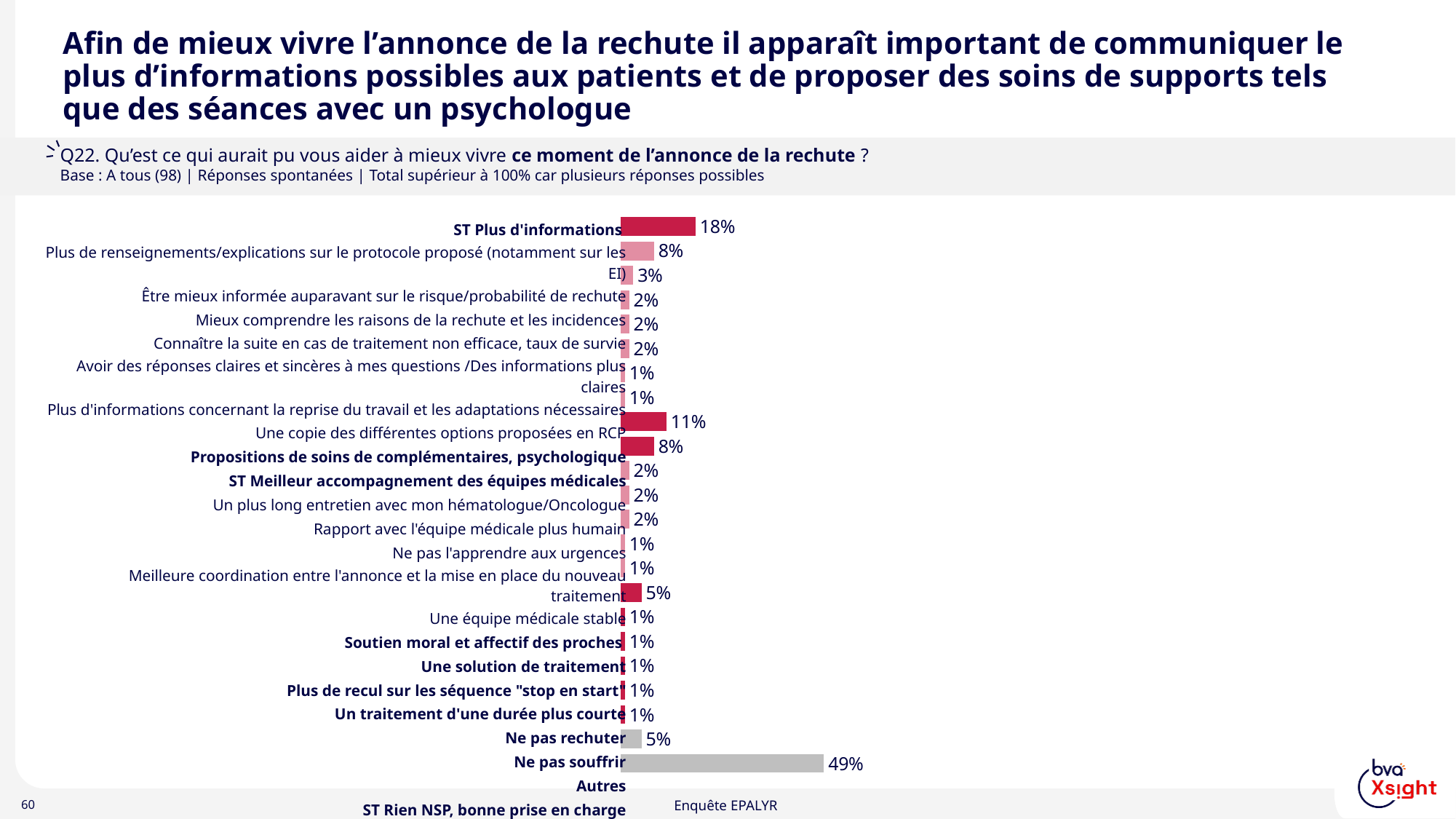
What is the second-highest value shown in the chart? 18% What is the value shown for 'ST Plus d'informations'? 18% What colour is the longest bar in the chart? grey What is the difference between the highest value (49%) and the value for 'ST Plus d'informations' (18%)? 31% What is the highest value shown in the chart? 49% How many bars are plotted in the chart? 23 What is the lowest value shown as a data label in the chart? 1% Is the highest value in the chart greater or less than 40%? greater What is the base (number of respondents) stated for the question Q22? 98 What kind of chart is shown on the slide? bar chart